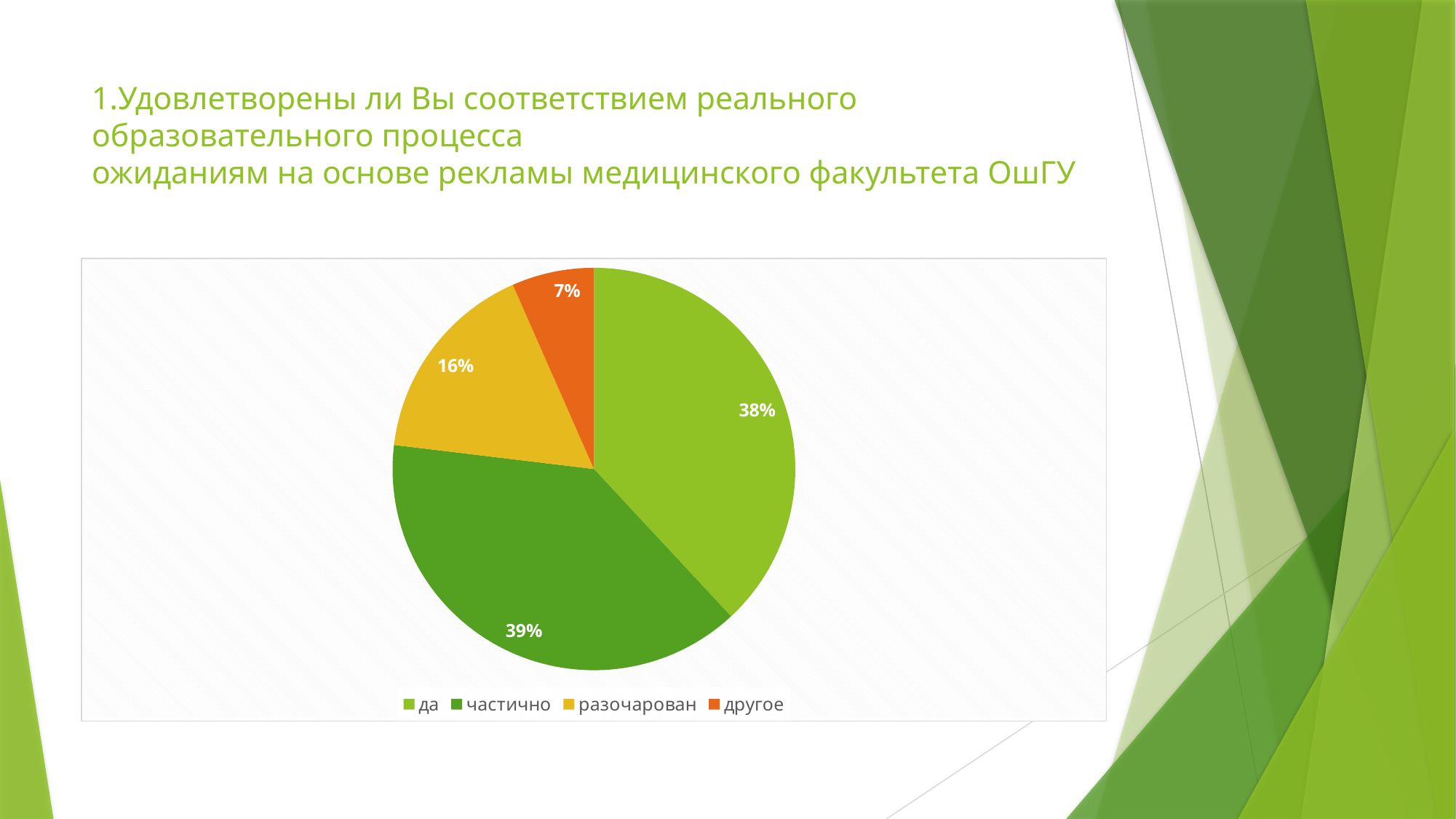
What percentage of respondents answered "да"? 38% How many slices does the pie chart have? 4 Which answer category has the smallest share of the pie? другое What is the difference in percentage points between "да" and "разочарован"? 22% What kind of chart is shown on the slide? pie chart What percentage of respondents answered "разочарован"? 16% What percentage of respondents answered "частично"? 39% What percentage of respondents answered "другое"? 7% What are the four entries listed in the chart legend? да, частично, разочарован, другое What is the difference in percentage points between "частично" and "другое"? 32% Which slice is larger, "разочарован" or "другое"? разочарован What combined share of the pie do "да" and "частично" make up together? 77%